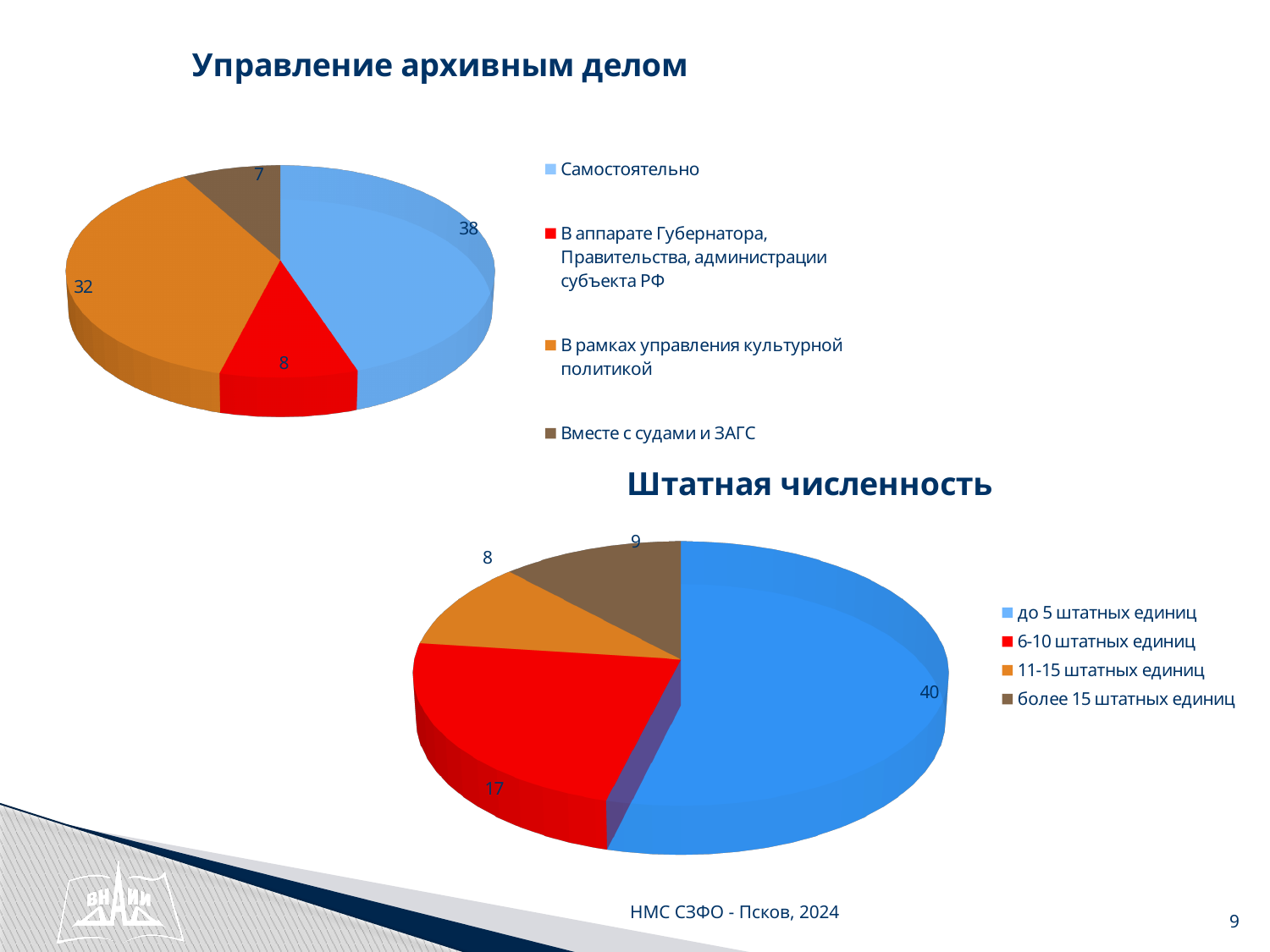
In the chart titled 'Управление архивным делом', which category has the smallest value? Вместе с судами и ЗАГС What type of chart is the chart titled 'Управление архивным делом'? Pie chart In the chart titled 'Управление архивным делом', what is the value for 'Самостоятельно'? 38 In the chart titled 'Штатная численность', which is larger: '11-15 штатных единиц' or 'более 15 штатных единиц'? более 15 штатных единиц In the chart titled 'Штатная численность', what is the value for '6-10 штатных единиц'? 17 In the chart titled 'Управление архивным делом', what is the difference between the values for 'Самостоятельно' and 'В аппарате Губернатора, Правительства, администрации субъекта РФ'? 30 In the chart titled 'Управление архивным делом', how many categories does the legend list? 4 In the chart titled 'Управление архивным делом', what is the value for 'В рамках управления культурной политикой'? 32 In the chart titled 'Штатная численность', which category has the largest value? до 5 штатных единиц In the chart titled 'Штатная численность', what is the difference between the values for 'до 5 штатных единиц' and '6-10 штатных единиц'? 23 In the chart titled 'Штатная численность', what is the total of all the slice values? 74 In the chart titled 'Штатная численность', what colour is the slice for '6-10 штатных единиц'? Red